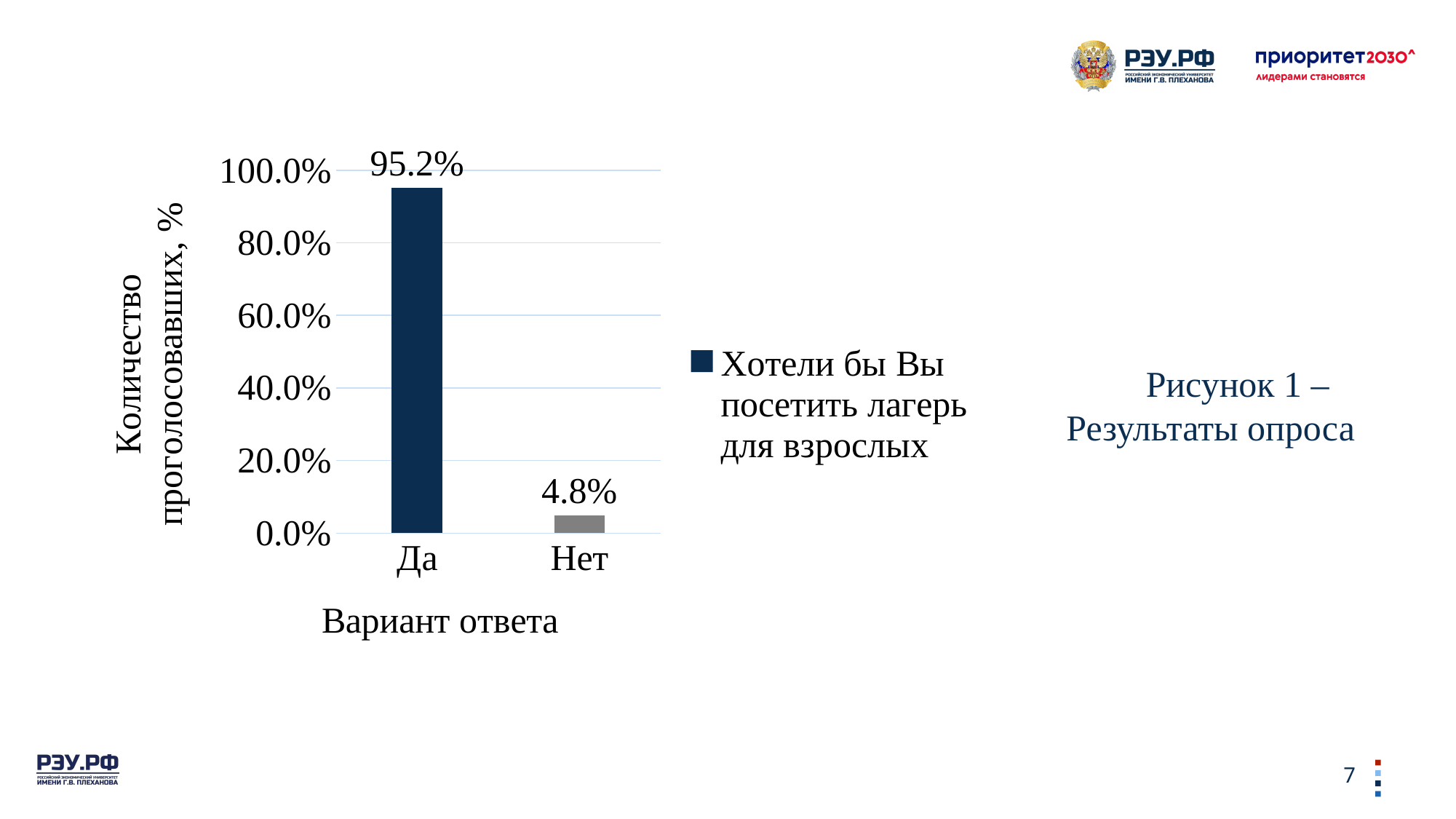
What is the value for "Да"? 95.2% How many series does the legend list? 1 What is the difference between the values for "Да" and "Нет"? 90.4% What is the label of the x axis? Вариант ответа Which answer option has the lowest value? Нет What kind of chart is shown on the slide? bar chart Is the value for "Нет" greater or less than 20.0%? less What is the value for "Нет"? 4.8% Is the value for "Да" greater or less than 80.0%? greater How many answer options are shown on the x axis? 2 Which answer option has the highest value? Да Which is larger, the value for "Да" or the value for "Нет"? Да